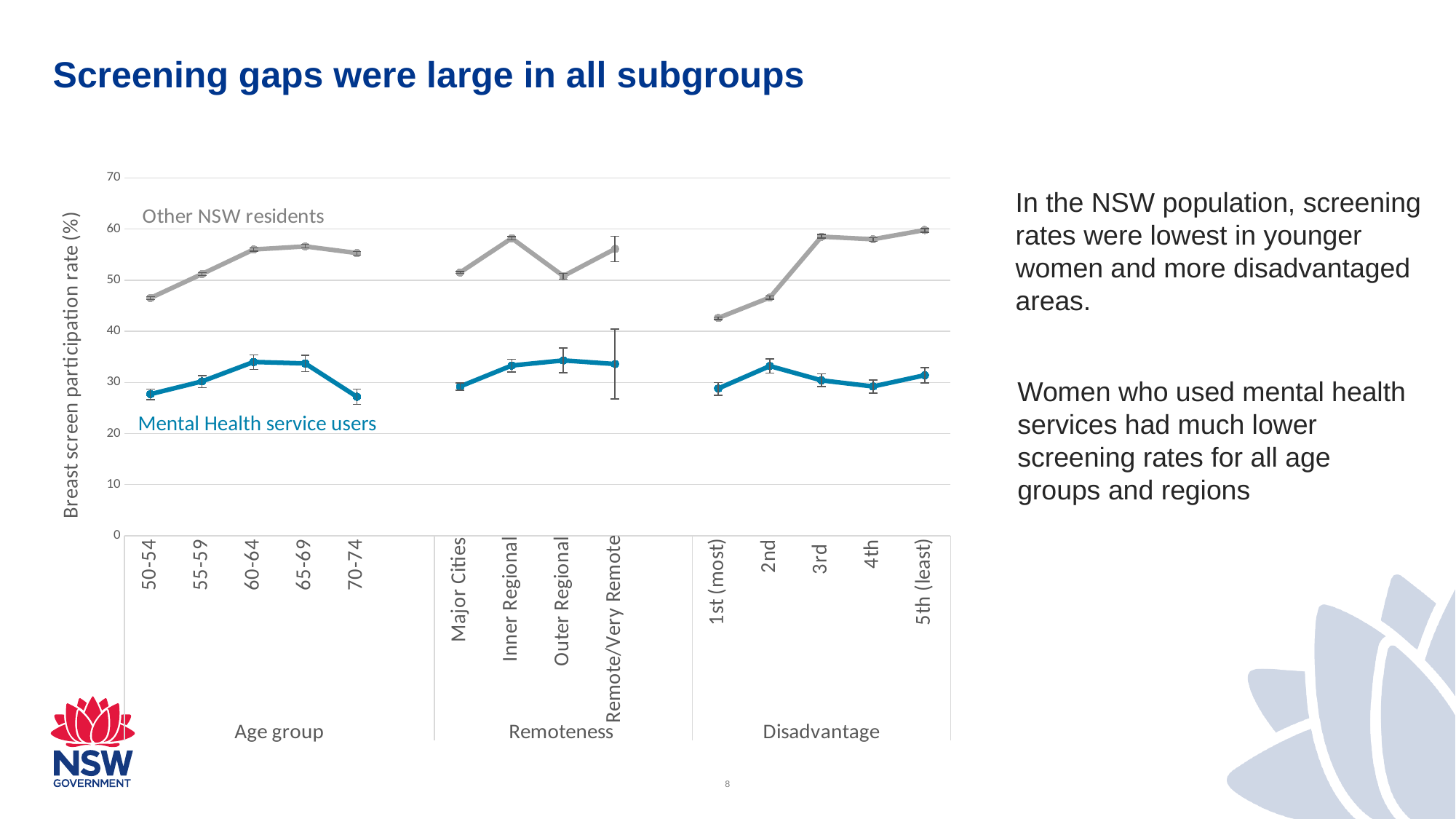
Among the remoteness categories, which has the highest value for Other NSW residents? Inner Regional For Major Cities, which series has the larger value: Other NSW residents or Mental Health service users? Other NSW residents Is the value for Mental Health service users in the 60-64 age group greater or less than 30? greater Is the value for Other NSW residents in the 50-54 age group greater or less than 50? less What are the three category groups labelled along the x axis? Age group, Remoteness, Disadvantage How many data series are plotted on the chart? 2 Is the value for Mental Health service users in the 70-74 age group greater or less than 30? less How many categories are shown along the x axis of the chart? 14 What is the label of the y axis? Breast screen participation rate (%) What kind of chart is shown on the slide? Line chart Among the age groups, which has the lowest value for Other NSW residents? 50-54